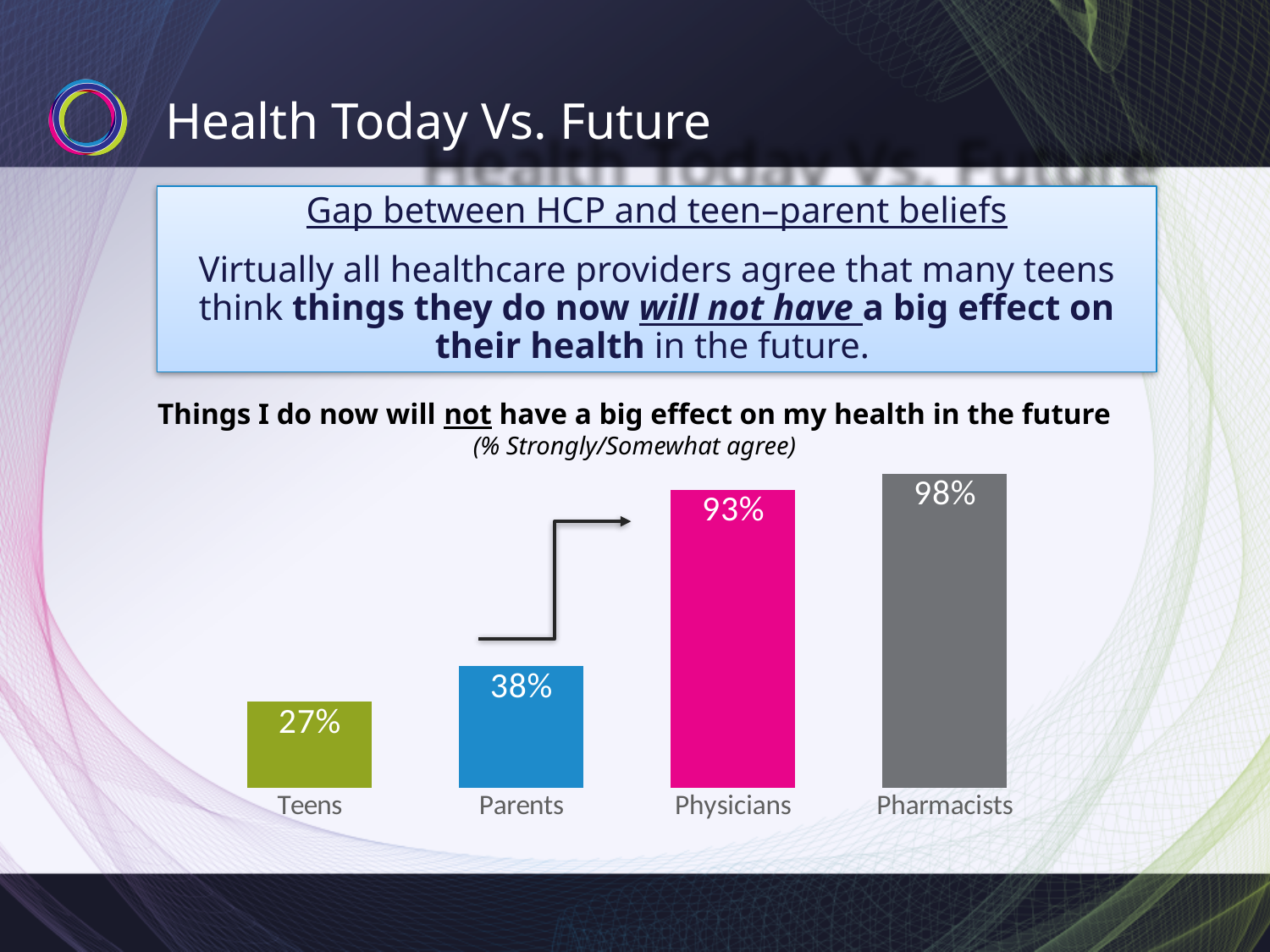
What kind of chart is shown on the slide? Bar chart Which group has the lowest value in the chart? Teens What percentage of Teens strongly or somewhat agree that things they do now will not have a big effect on their health in the future? 27% What is the difference between the values for Parents and Teens? 11 percentage points Which is larger, the value for Physicians or the value for Parents? Physicians What is the difference between the values for Pharmacists and Teens? 71 percentage points What is the value shown for Pharmacists in the chart? 98% Do the values rise or fall moving from Teens to Pharmacists along the x axis? Rise What is the value shown for Parents in the chart? 38% Which group has the highest value in the chart? Pharmacists How many groups are shown in the chart? 4 What is the value shown for Physicians in the chart? 93%